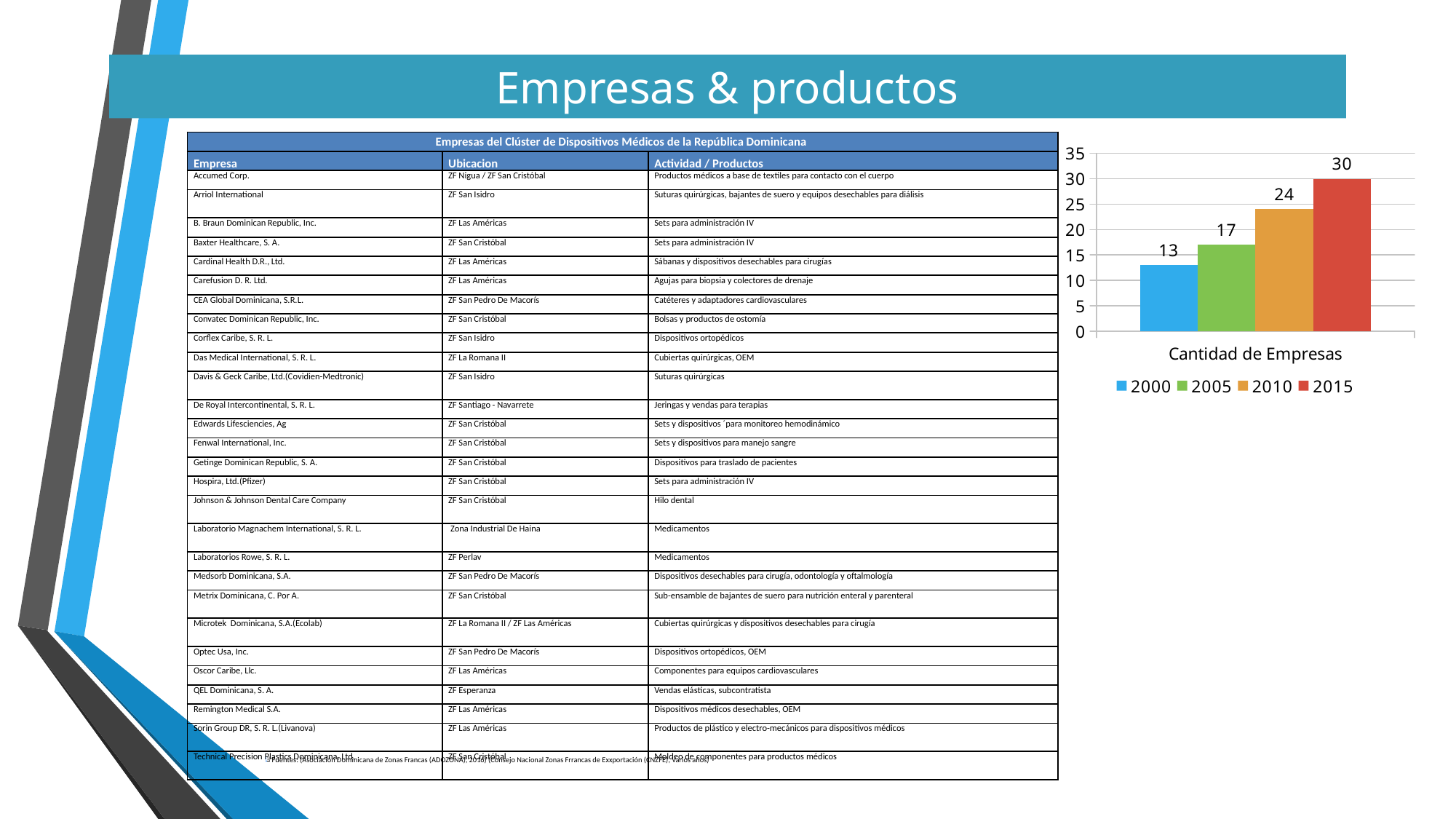
What is the difference between the 2015 and 2000 values in the Cantidad de Empresas chart? 17 Do the values in the Cantidad de Empresas chart rise or fall from 2000 to 2015? rise What is the value for 2000 in the Cantidad de Empresas chart? 13 Which year has the highest value in the Cantidad de Empresas chart? 2015 What is the value for 2005 in the Cantidad de Empresas chart? 17 What colour is the bar for 2015 in the Cantidad de Empresas chart? red How many series does the legend of the Cantidad de Empresas chart list? 4 What is the value for 2010 in the Cantidad de Empresas chart? 24 What kind of chart is the Cantidad de Empresas chart? bar chart In the Cantidad de Empresas chart, which is larger: the value for 2005 or the value for 2010? 2010 Which year has the lowest value in the Cantidad de Empresas chart? 2000 What is the value for 2015 in the Cantidad de Empresas chart? 30